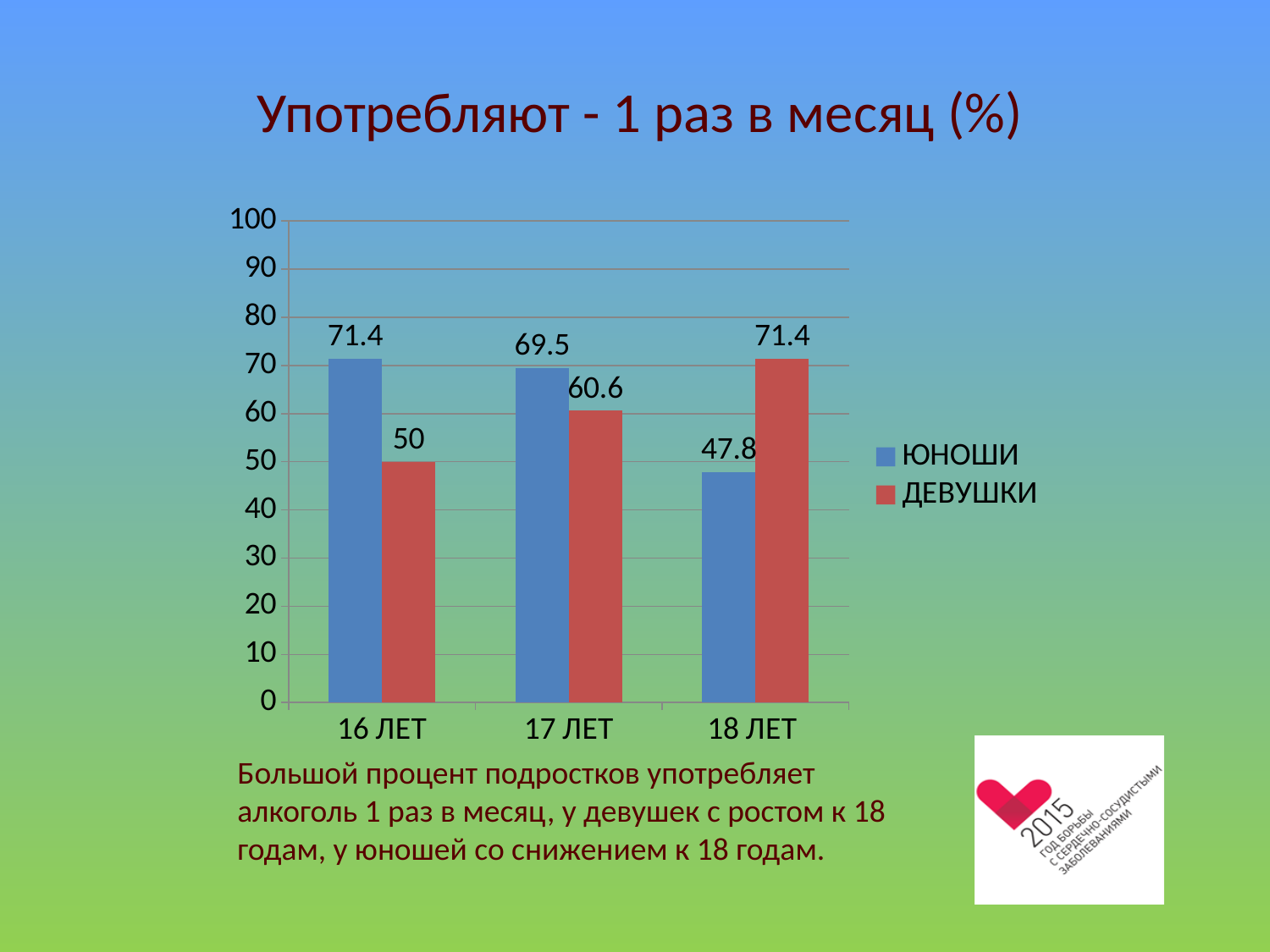
At which age group is the ЮНОШИ value lowest? 18 ЛЕТ What is the value for ЮНОШИ at 16 ЛЕТ? 71.4 What is the value for ЮНОШИ at 18 ЛЕТ? 47.8 What is the difference between the ЮНОШИ and ДЕВУШКИ values at 16 ЛЕТ? 21.4 Which is larger at 18 ЛЕТ, the ЮНОШИ value or the ДЕВУШКИ value? ДЕВУШКИ How many age groups are shown on the x axis? 3 What kind of chart is shown on the slide? bar chart How many series does the legend list? 2 Do the ДЕВУШКИ values rise or fall from 16 ЛЕТ to 18 ЛЕТ? rise What is the value for ДЕВУШКИ at 17 ЛЕТ? 60.6 What is the value for ДЕВУШКИ at 16 ЛЕТ? 50 At which age group is the ДЕВУШКИ value highest? 18 ЛЕТ